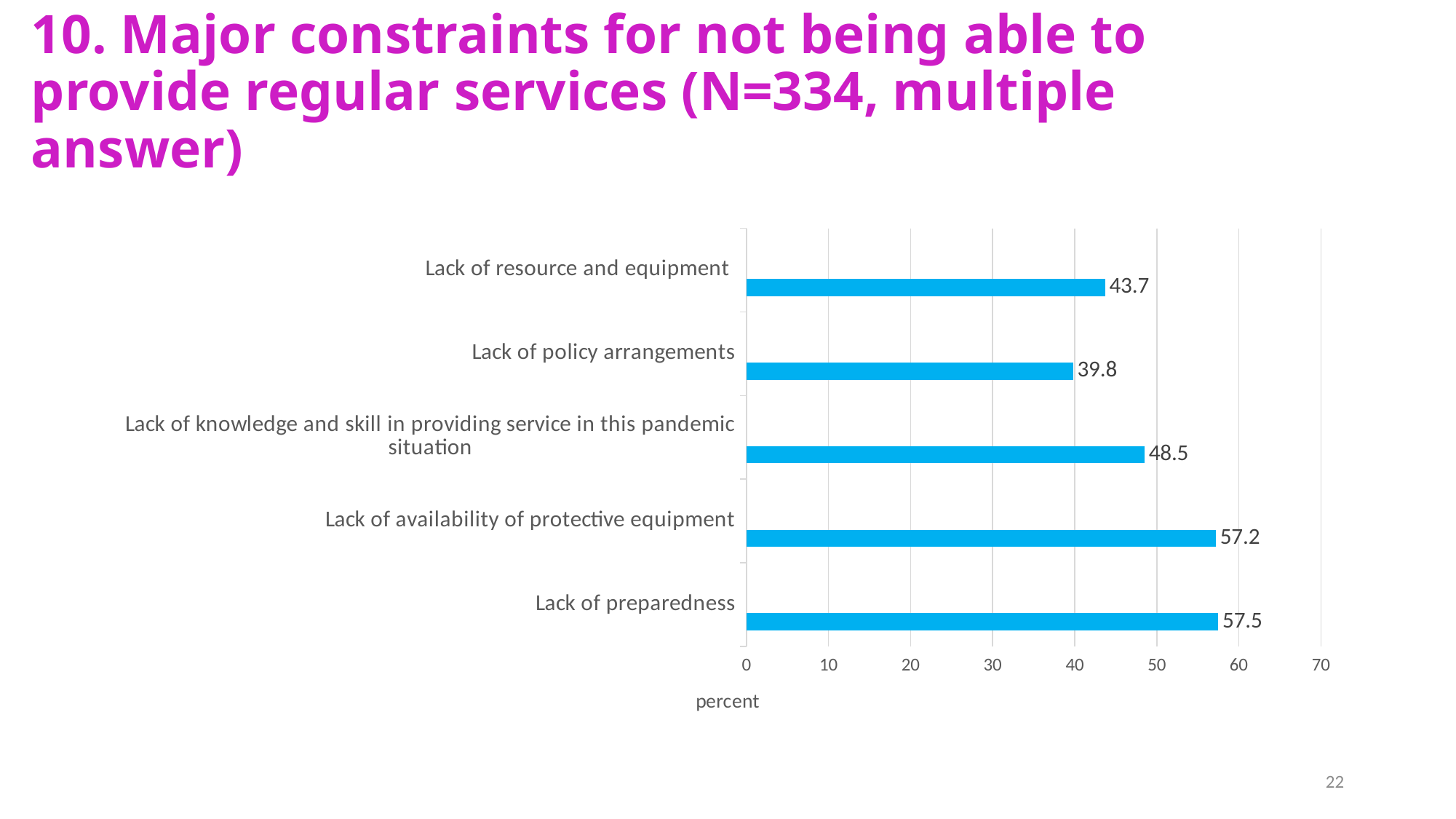
What is the value for Lack of preparedness? 57.5 What kind of chart is shown on the slide? bar chart What is the value for Lack of knowledge and skill in providing service in this pandemic situation? 48.5 How many constraint categories are shown in the chart? 5 What is the label on the horizontal axis of the chart? percent What is the value for Lack of policy arrangements? 39.8 Which is larger, the value for Lack of resource and equipment or the value for Lack of policy arrangements? Lack of resource and equipment Which constraint has the lowest value? Lack of policy arrangements What is the difference between the values for Lack of knowledge and skill in providing service in this pandemic situation and Lack of policy arrangements? 8.7 Is the value for Lack of availability of protective equipment greater or less than 50? greater What is the value for Lack of availability of protective equipment? 57.2 What is the value for Lack of resource and equipment? 43.7